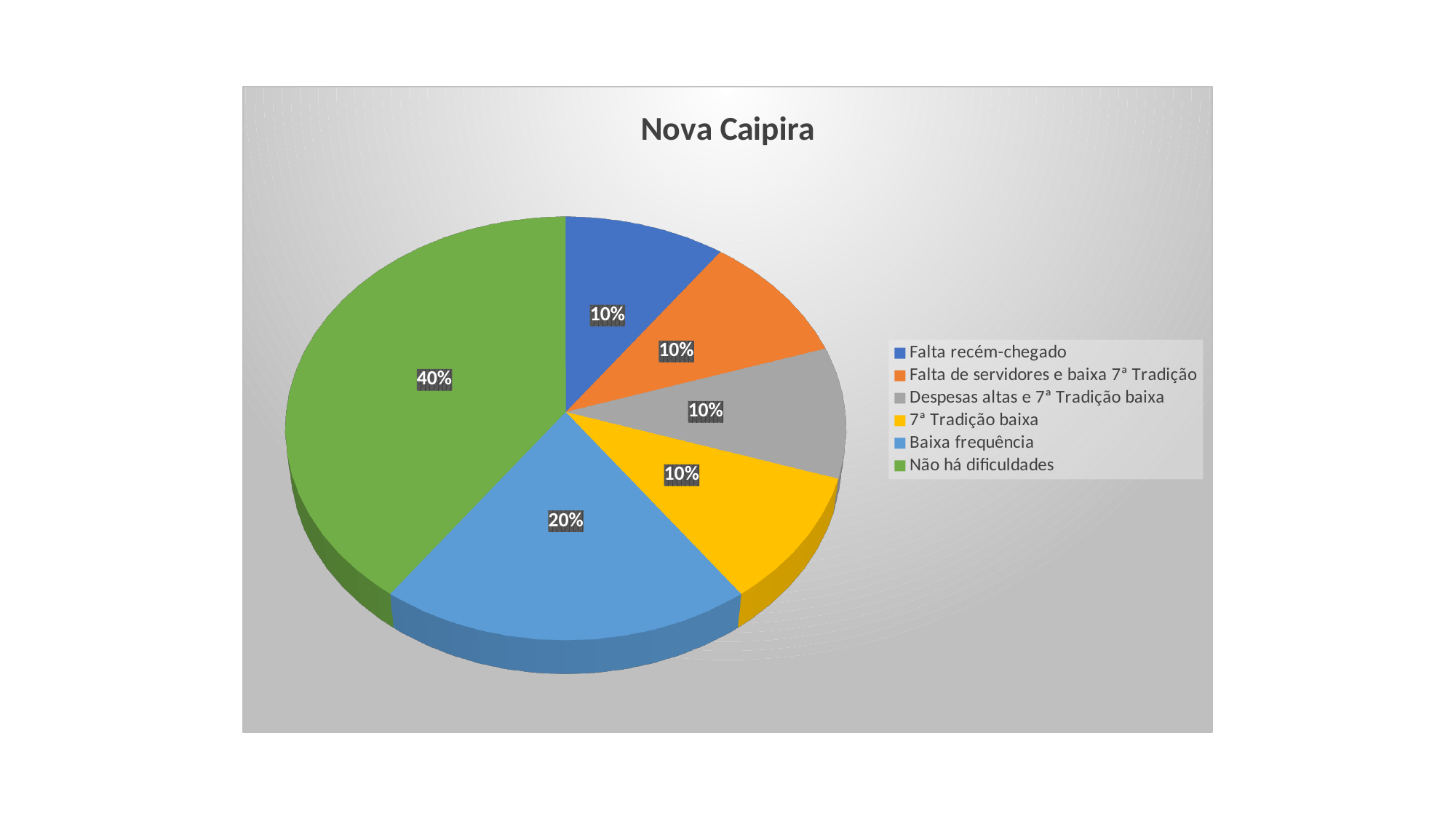
Which is larger, the slice for 'Baixa frequência' or the slice for 'Despesas altas e 7ª Tradição baixa'? Baixa frequência What kind of chart is shown on the slide? pie chart What is the value shown for 'Falta recém-chegado'? 10% Which category has the largest slice of the pie? Não há dificuldades What is the value shown for '7ª Tradição baixa'? 10% What share of the pie does 'Não há dificuldades' represent? 40% What is the title of the chart? Nova Caipira What is the difference between the shares of 'Não há dificuldades' and 'Baixa frequência'? 20% How many entries does the legend list? 6 How many slices does the pie chart have? 6 What share of the pie does 'Baixa frequência' represent? 20% What colour is the slice for 'Falta de servidores e baixa 7ª Tradição'? orange